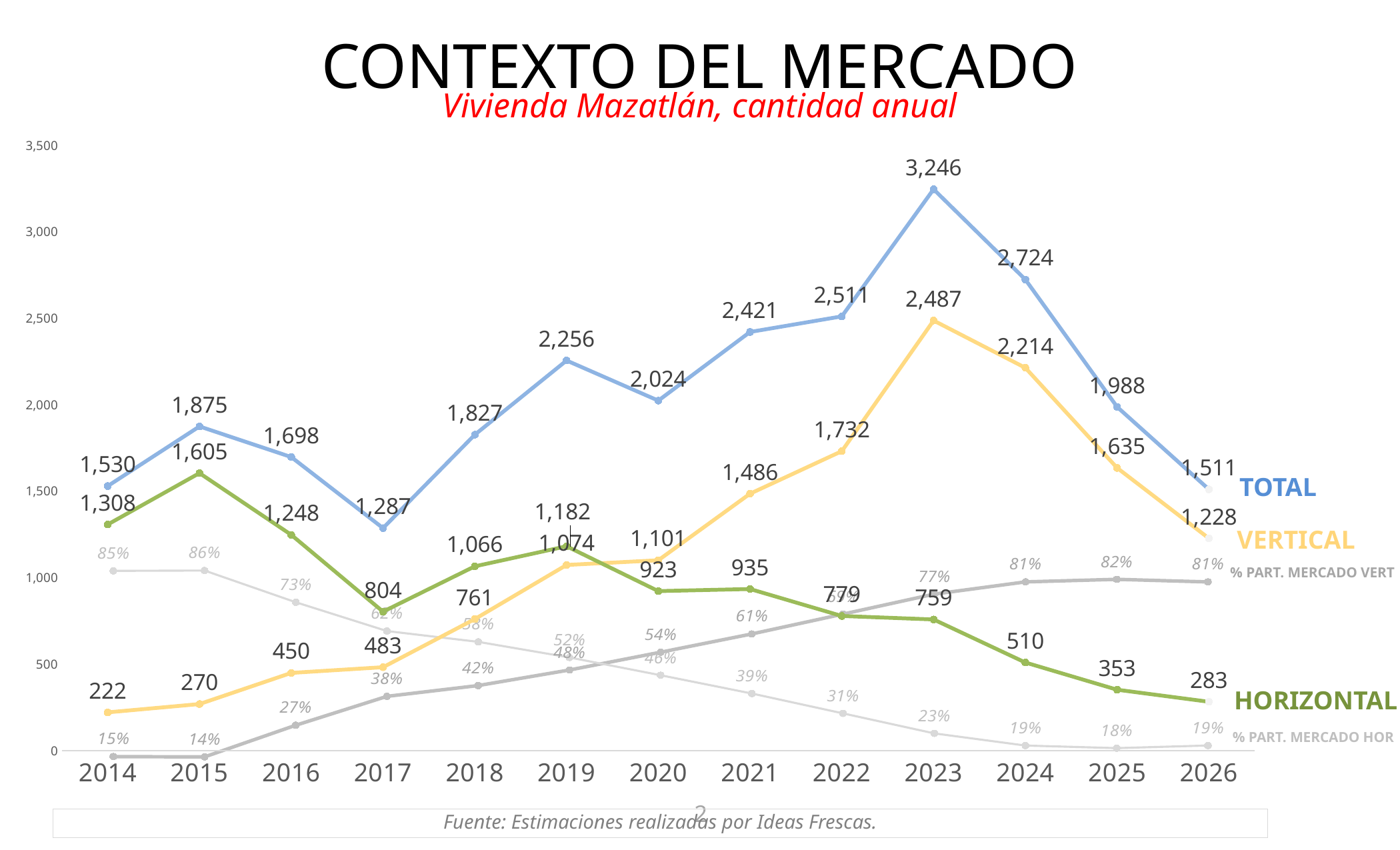
How many series are labelled on the chart? 5 What kind of chart is shown on the slide? line chart In which year is the TOTAL series highest? 2023 What is the TOTAL value for 2023? 3,246 Is the VERTICAL value for 2016 greater or less than 500? less Does the TOTAL series rise or fall from 2023 to 2026? fall What is the % PART. MERCADO VERT value for 2026? 81% What is the HORIZONTAL value for 2017? 804 In which year is the HORIZONTAL series lowest? 2026 What is the difference between the VERTICAL values for 2023 and 2024? 273 How many years are shown on the x axis? 13 In 2019, which is larger: the VERTICAL value or the HORIZONTAL value? HORIZONTAL